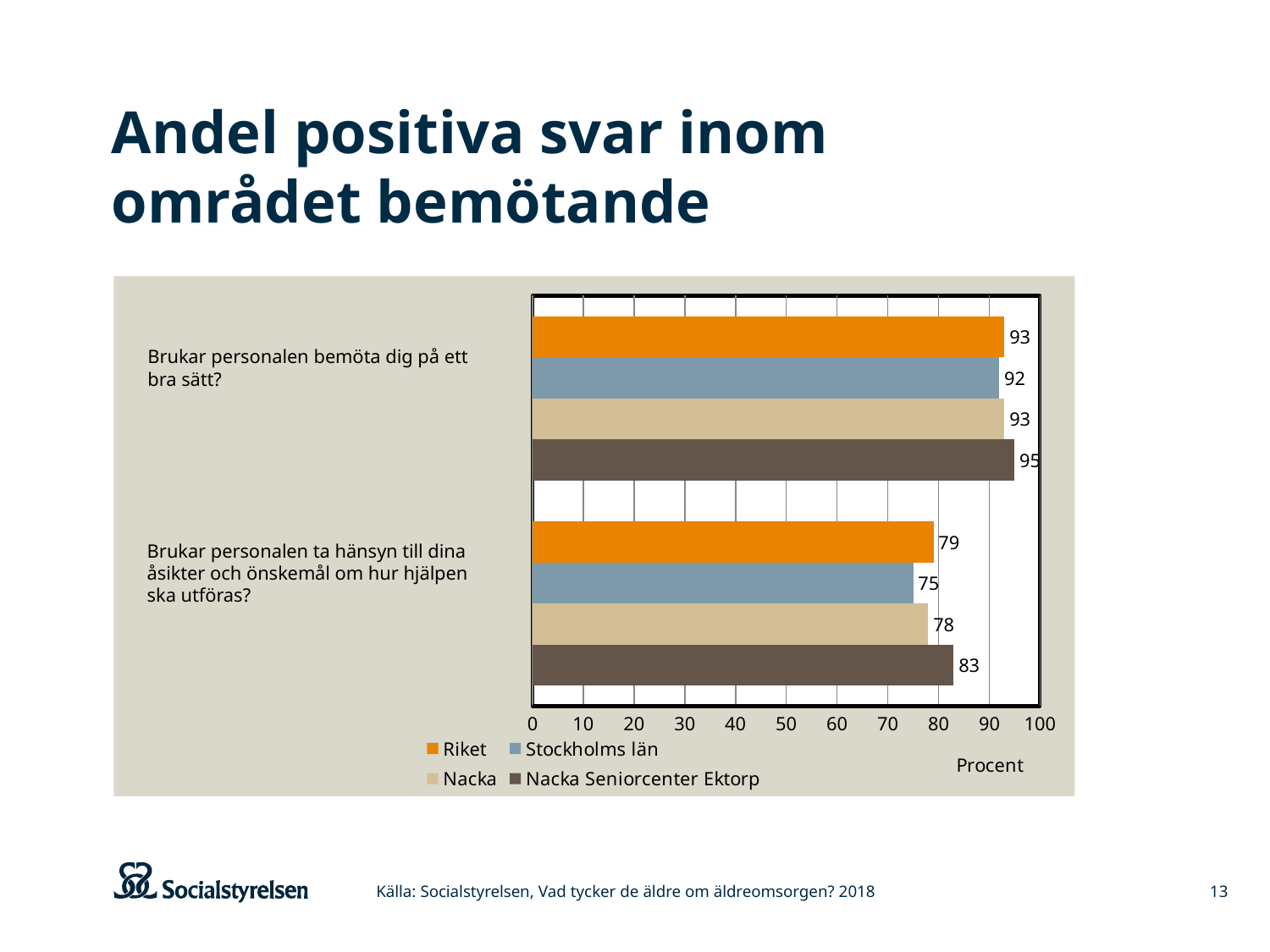
What is the value for Riket for the question "Brukar personalen ta hänsyn till dina åsikter och önskemål om hur hjälpen ska utföras?"? 79 What kind of chart is shown on the slide? bar chart What is the value for Stockholms län for the question "Brukar personalen ta hänsyn till dina åsikter och önskemål om hur hjälpen ska utföras?"? 75 Which series has the highest value for the question "Brukar personalen ta hänsyn till dina åsikter och önskemål om hur hjälpen ska utföras?"? Nacka Seniorcenter Ektorp Which series has the lowest value for the question "Brukar personalen ta hänsyn till dina åsikter och önskemål om hur hjälpen ska utföras?"? Stockholms län How many series does the legend list? 4 How many questions (categories) are shown on the chart? 2 What is the value for Nacka Seniorcenter Ektorp for the question "Brukar personalen bemöta dig på ett bra sätt?"? 95 What is the difference between the Nacka Seniorcenter Ektorp value and the Stockholms län value for the question "Brukar personalen ta hänsyn till dina åsikter och önskemål om hur hjälpen ska utföras?"? 8 For Nacka, which question has the larger value: "Brukar personalen bemöta dig på ett bra sätt?" or "Brukar personalen ta hänsyn till dina åsikter och önskemål om hur hjälpen ska utföras?"? Brukar personalen bemöta dig på ett bra sätt? What is the difference between the Nacka Seniorcenter Ektorp value and the Riket value for the question "Brukar personalen bemöta dig på ett bra sätt?"? 2 What is the label of the horizontal axis? Procent